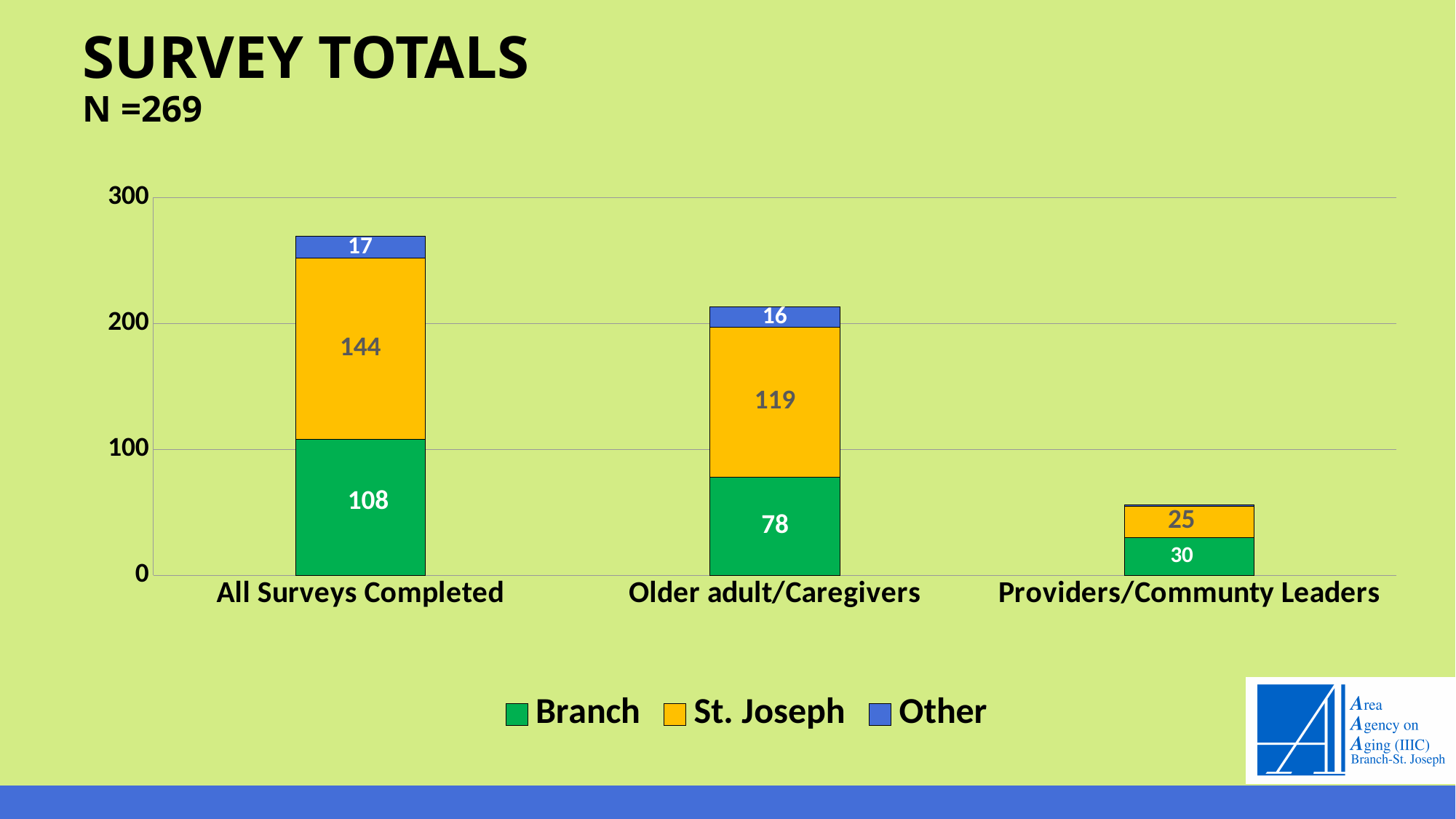
What is the Branch value for All Surveys Completed? 108 What is the St. Joseph value for Providers/Communty Leaders? 25 Which is larger for Providers/Communty Leaders, the Branch value or the St. Joseph value? Branch What kind of chart is shown on the slide? Stacked bar chart What is the difference between the St. Joseph and Branch values for Older adult/Caregivers? 41 How many series does the legend list? 3 How many categories are shown on the x axis? 3 What is the St. Joseph value for Older adult/Caregivers? 119 Which category has the lowest Branch value? Providers/Communty Leaders What is the Other value for All Surveys Completed? 17 Which category has the highest St. Joseph value? All Surveys Completed What is the total of the stacked bar for All Surveys Completed? 269